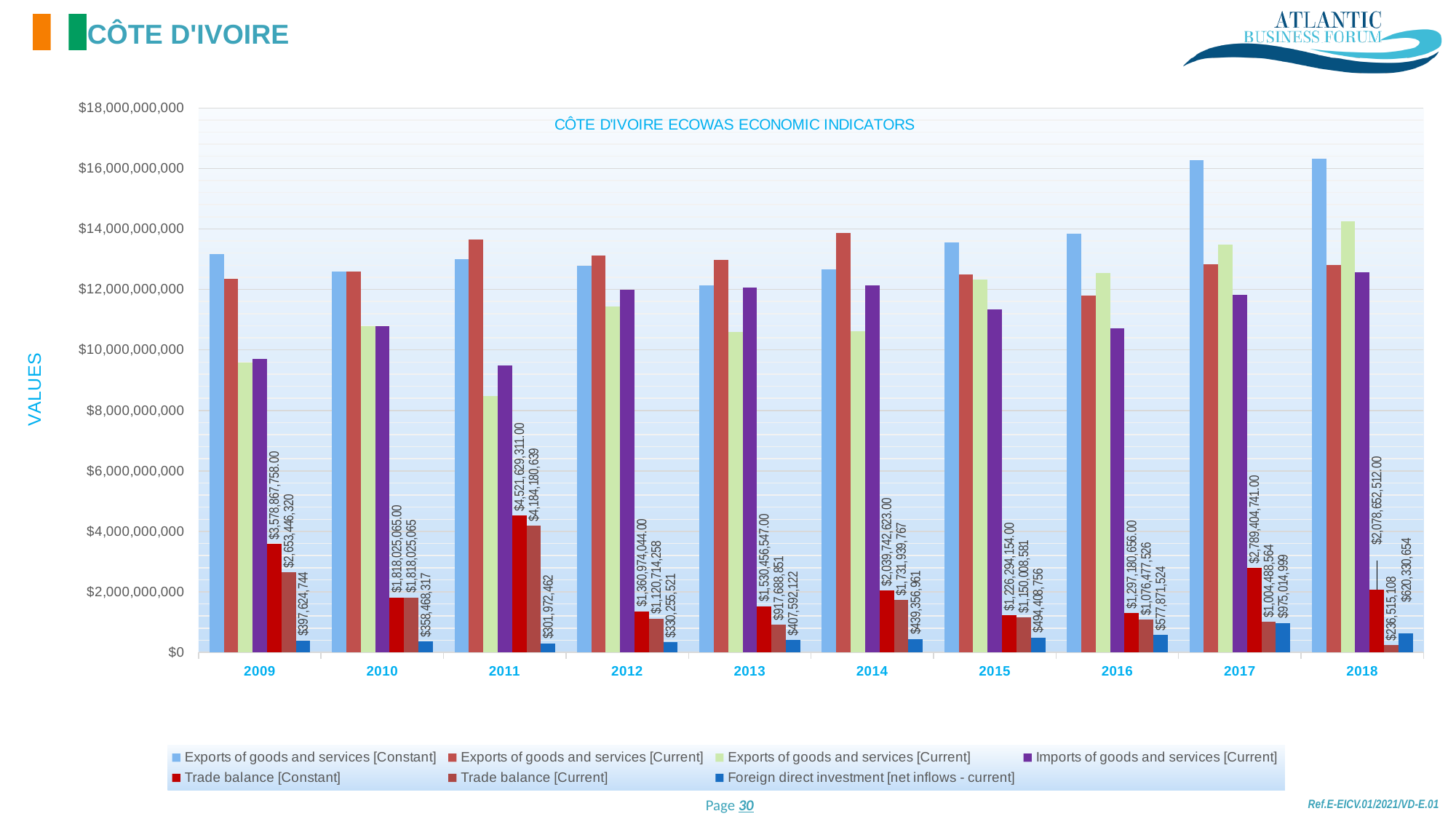
In which year is Foreign direct investment [net inflows - current] highest? 2017 In which year is Trade balance [Constant] highest? 2011 What kind of chart is shown on the slide? Bar chart What is the value of Trade balance [Current] in 2018? $236,515,108 How many years are shown along the x axis of the chart? 10 What is the difference between Foreign direct investment [net inflows - current] in 2017 and in 2018? $354,684,345 In which year is Foreign direct investment [net inflows - current] lowest? 2011 What is the value of Trade balance [Constant] in 2011? $4,521,629,311.00 What is the value of Foreign direct investment [net inflows - current] in 2017? $975,014,999 Is the value of Exports of goods and services [Constant] in 2018 greater or less than $16,000,000,000? greater Which is larger: Imports of goods and services [Current] in 2009 or in 2012? 2012 How many series does the chart's legend list? 7